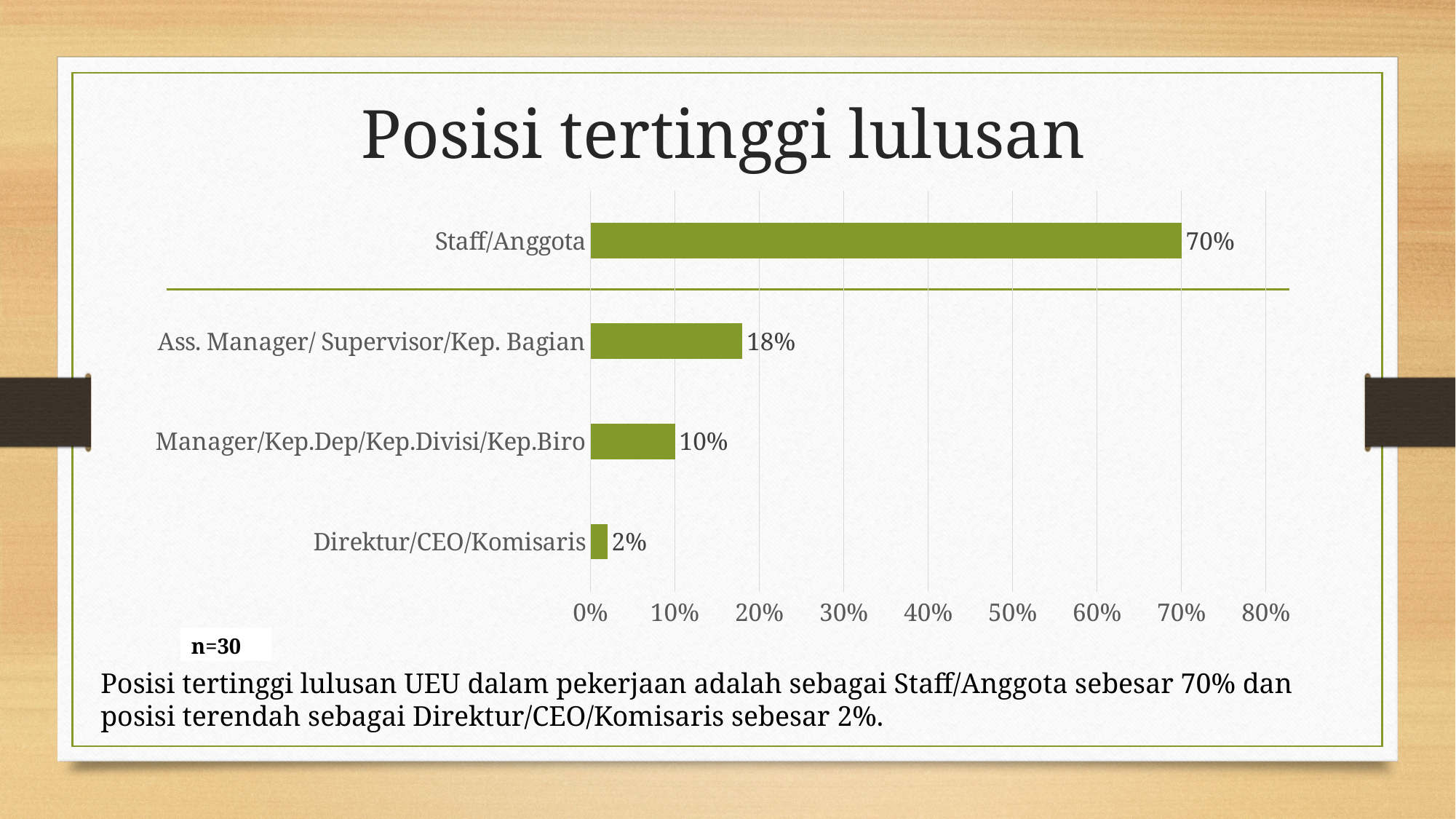
What is the value for Direktur/CEO/Komisaris? 2% What is the difference between the values for Staff/Anggota and Ass. Manager/ Supervisor/Kep. Bagian? 52% Which is larger, the value for Ass. Manager/ Supervisor/Kep. Bagian or the value for Manager/Kep.Dep/Kep.Divisi/Kep.Biro? Ass. Manager/ Supervisor/Kep. Bagian What kind of chart is shown on the slide? Bar chart How many categories are shown in the chart? 4 What is the value for Staff/Anggota? 70% What is the value for Manager/Kep.Dep/Kep.Divisi/Kep.Biro? 10% What is the difference between the values for Manager/Kep.Dep/Kep.Divisi/Kep.Biro and Direktur/CEO/Komisaris? 8% What is the title of the slide? Posisi tertinggi lulusan Which category has the highest value? Staff/Anggota What is the value for Ass. Manager/ Supervisor/Kep. Bagian? 18% Which category has the lowest value? Direktur/CEO/Komisaris